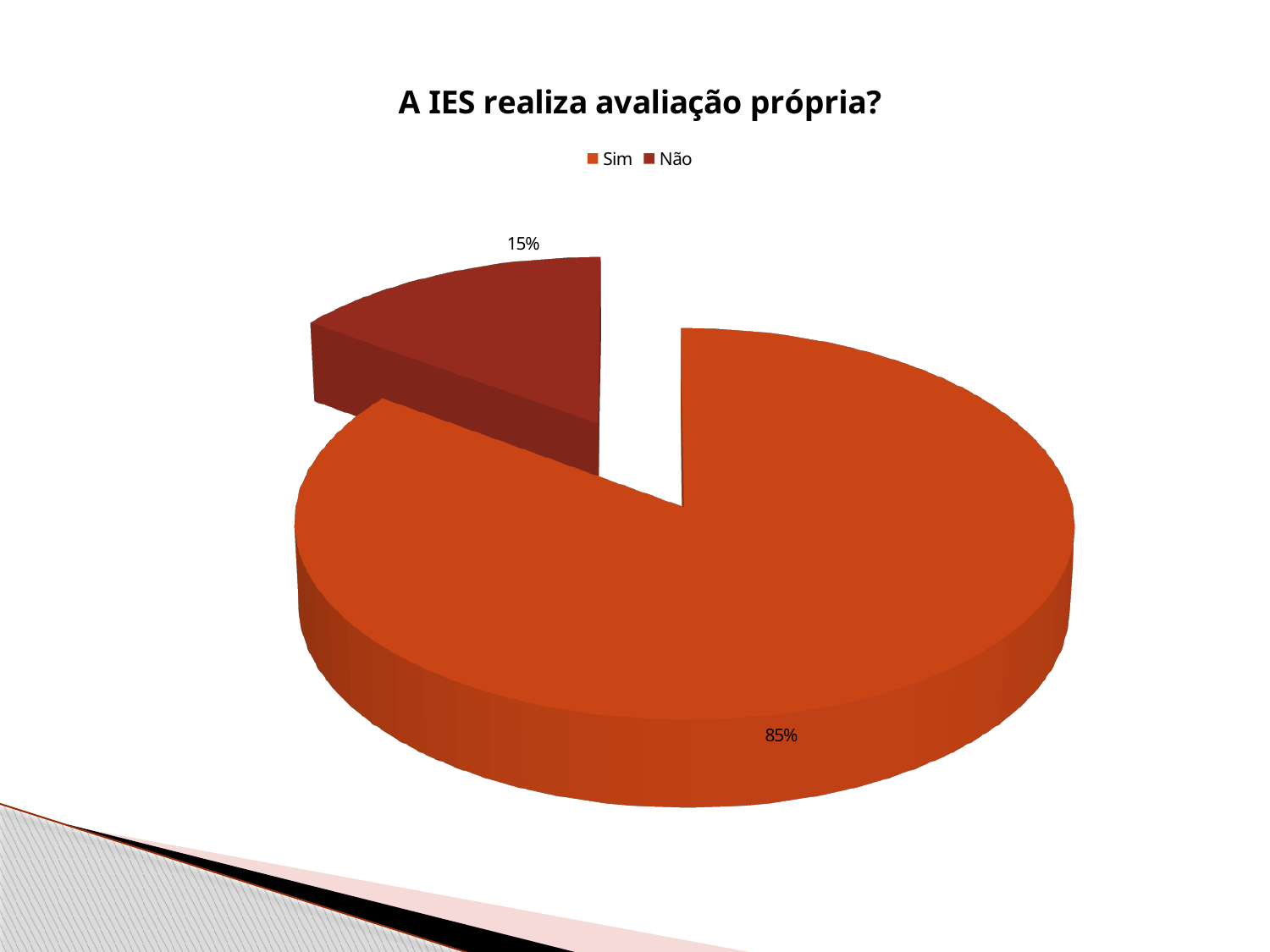
What percentage of the pie corresponds to "Não"? 15% What is the difference in percentage points between the "Sim" and "Não" slices? 70 What kind of chart is shown on the slide? Pie chart What percentage of the pie corresponds to "Sim"? 85% Which category has the smallest share of the pie? Não Which category has the largest share of the pie? Sim How many entries does the legend list? 2 Which is larger, the "Sim" slice or the "Não" slice? Sim What share of the pie does the "Não" slice represent? 15% How many slices does the pie chart have? 2 Which slice is pulled out (exploded) from the pie? Não What is the title of the chart? A IES realiza avaliação própria?